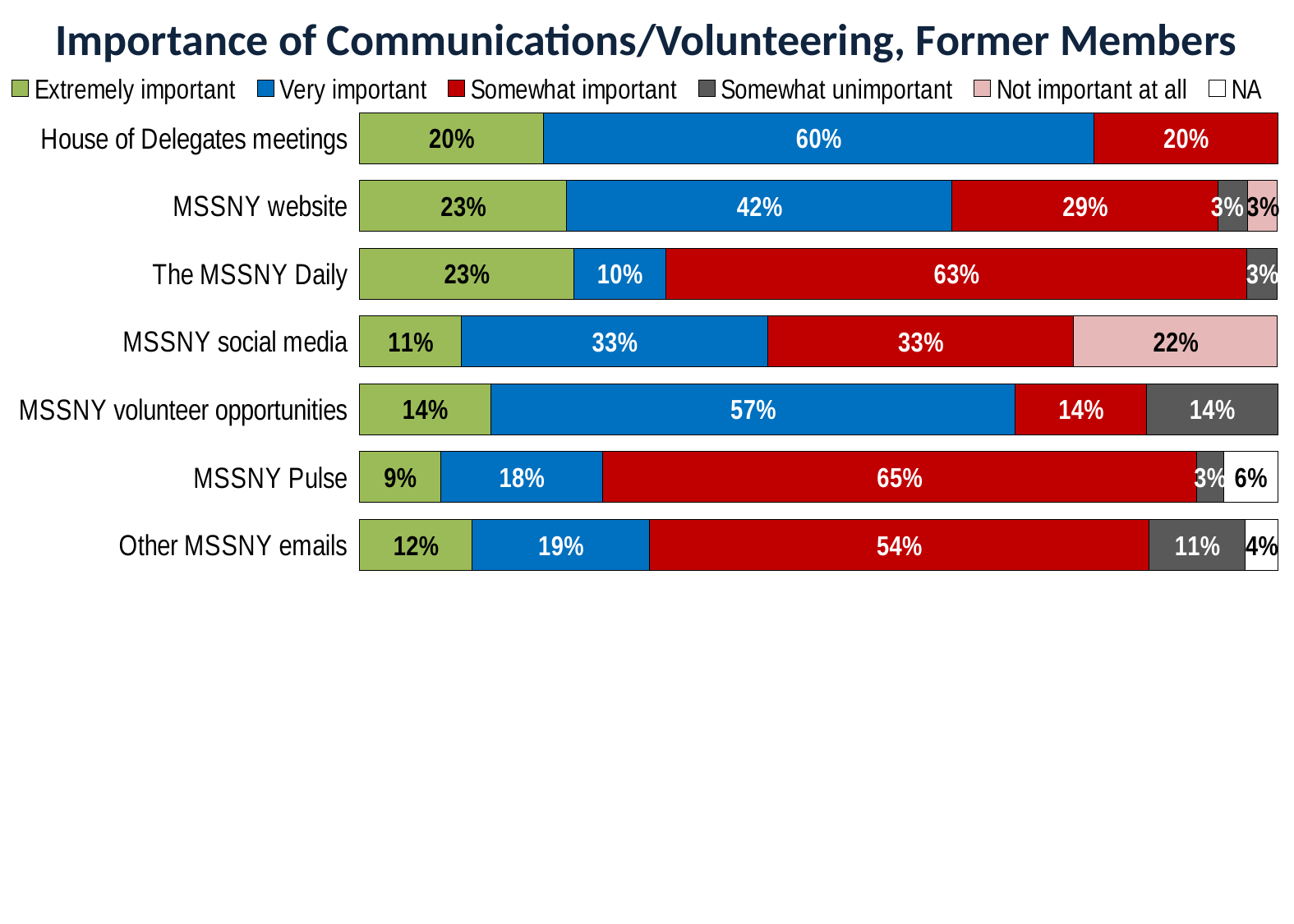
Which category has the highest Somewhat important percentage? MSSNY Pulse How many series does the legend list? 6 Which is larger: the Somewhat important percentage for MSSNY website or for Other MSSNY emails? Other MSSNY emails How many categories are shown in the chart? 7 What percentage of former members rated MSSNY Pulse as Extremely important? 9% What is the difference between the Very important percentages for MSSNY volunteer opportunities and The MSSNY Daily? 47% What is the title of the chart? Importance of Communications/Volunteering, Former Members What percentage of former members rated The MSSNY Daily as Somewhat important? 63% What kind of chart is shown on the slide? Stacked bar chart What percentage of former members rated House of Delegates meetings as Very important? 60% What percentage of former members rated MSSNY social media as Not important at all? 22% Which category has the lowest Extremely important percentage? MSSNY Pulse